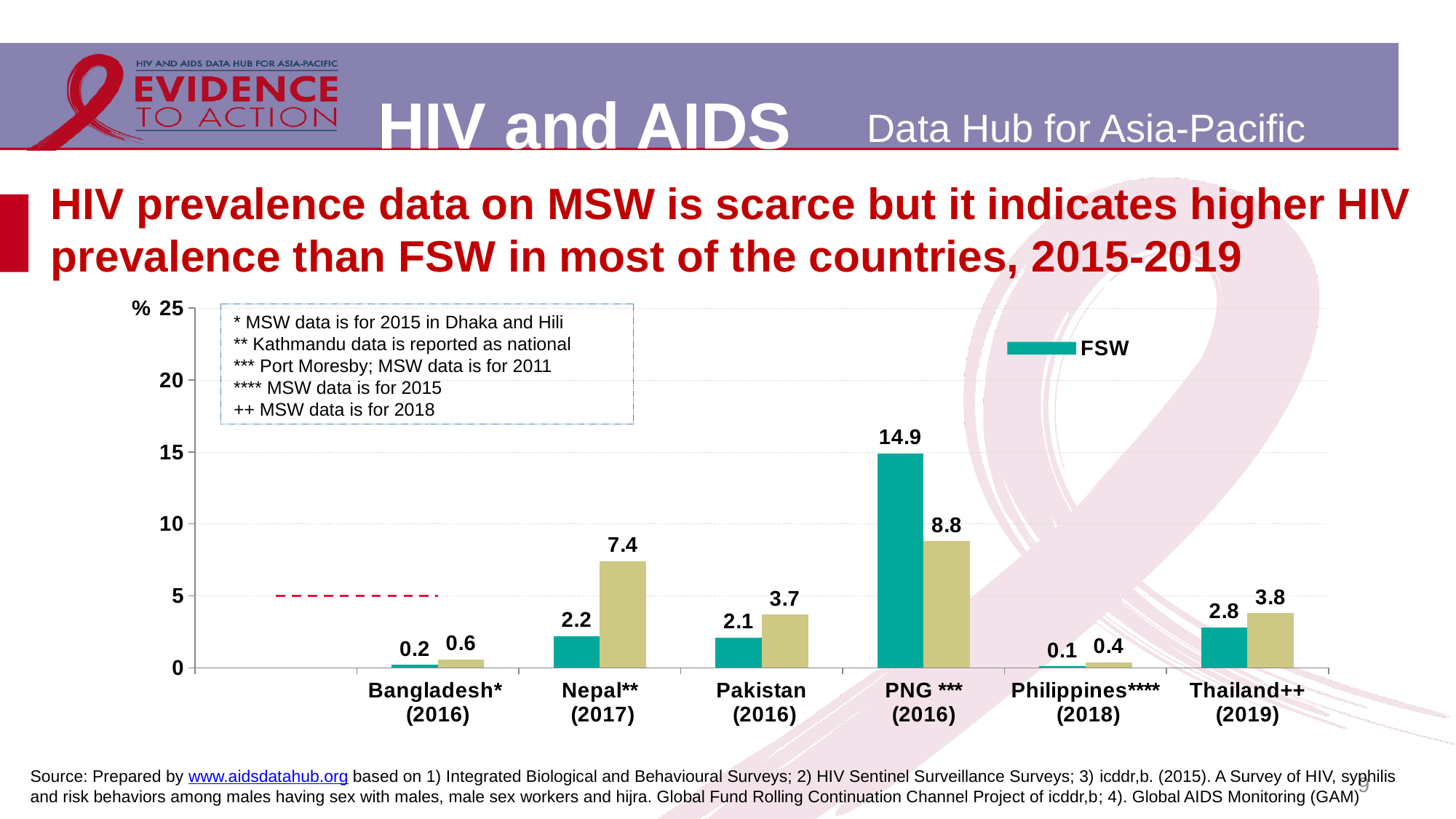
What is the difference between the FSW value and the tan bar value for PNG *** (2016)? 6.1 Is the FSW value for PNG *** (2016) greater or less than 10? greater How many countries are shown on the x axis of the chart? 6 What is the FSW value for Thailand++ (2019)? 2.8 Which country has the highest FSW value? PNG *** (2016) What kind of chart is shown on the slide? Bar chart Which country has the lowest FSW value? Philippines**** (2018) What is the value of the tan (non-FSW) bar for Nepal** (2017)? 7.4 Which country has the highest value among the tan (non-FSW) bars? PNG *** (2016) What colour are the FSW bars in the chart? Teal What is the FSW value for PNG *** (2016)? 14.9 For Nepal** (2017), which is larger: the FSW bar or the tan bar? The tan bar (7.4)